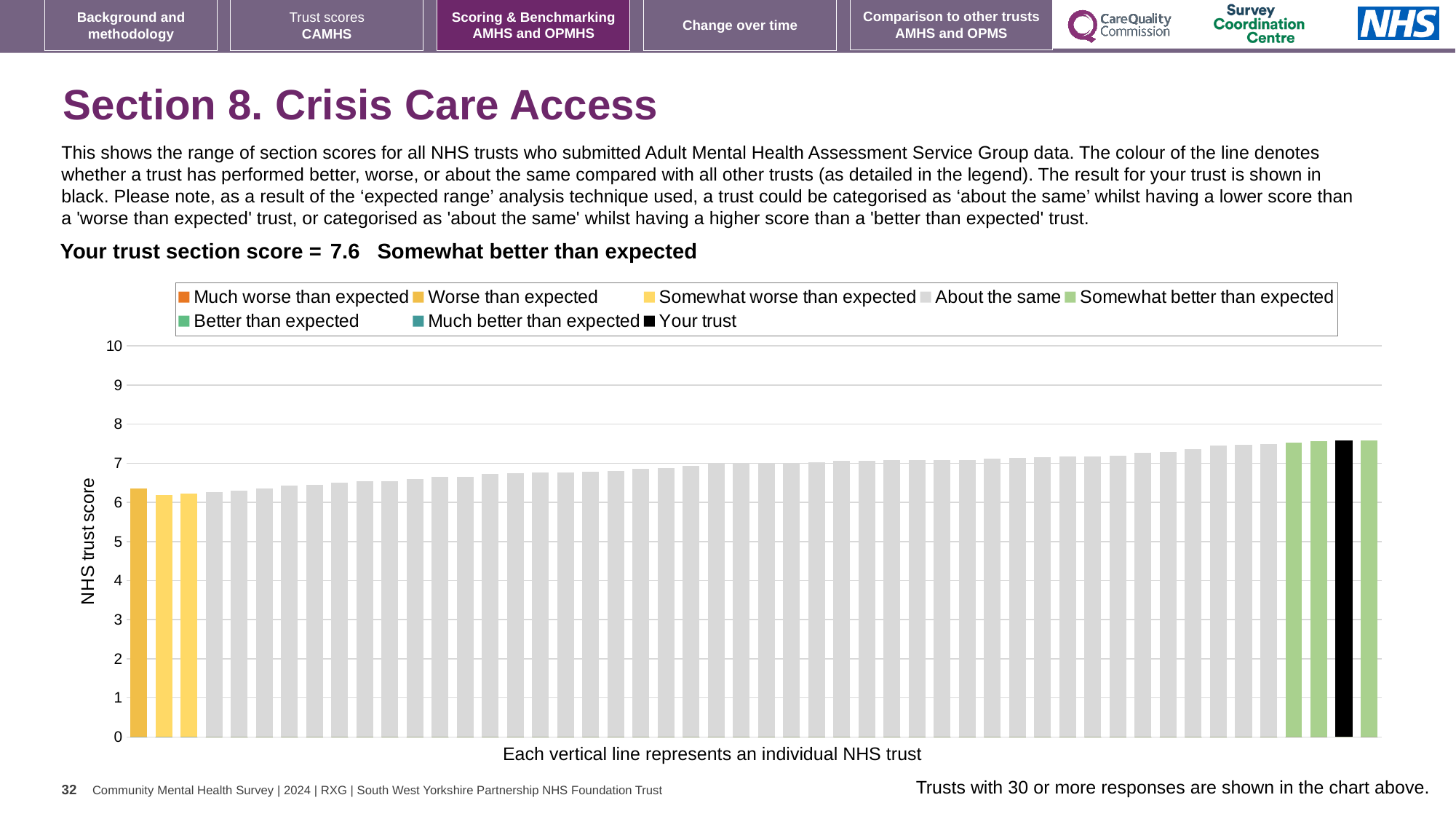
What is the label on the vertical axis of the chart? NHS trust score Is the value for your trust (the black bar) greater or less than 7? greater Is the value of the highest bar in the chart greater or less than 8? less Which is larger: the value of the black bar for your trust or the value of the leftmost orange bar? the black bar for your trust Which category does your trust's score fall into according to the slide? Somewhat better than expected How many entries does the chart legend list? 8 Do the bar values rise or fall from left to right along the x axis? rise How many bars in the chart are coloured black? 1 Is the value of the lowest bar in the chart greater or less than 7? less What is the section score for your trust shown on the slide? 7.6 What colour does the legend use for 'Your trust'? black What kind of chart is shown on the slide? bar chart